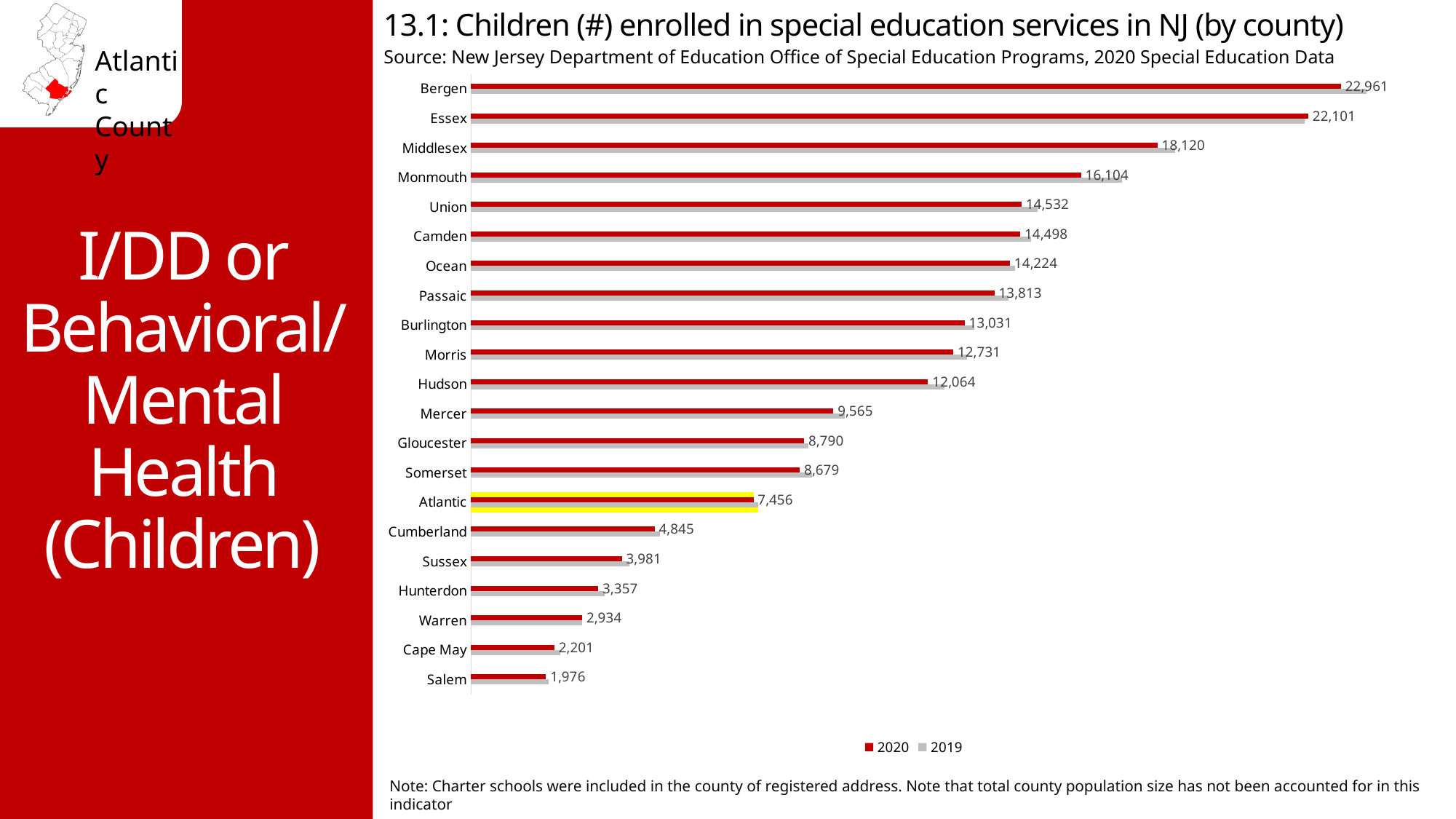
Which county has a larger 2020 value, Middlesex or Monmouth? Middlesex How many series does the legend list? 2 Which county has the highest 2020 number of children enrolled in special education services? Bergen What is the difference between the 2020 values for Bergen and Essex? 860 What is the 2020 value shown for Salem County? 1,976 What is the difference between the 2020 values for Atlantic and Cumberland? 2,611 Which county has the lowest 2020 number of children enrolled in special education services? Salem How many counties are shown in the chart? 21 What is the 2020 value shown for Bergen County? 22,961 What kind of chart is used to show children enrolled in special education services by county? Bar chart Which year does the red series in the legend represent? 2020 What is the 2020 number of children enrolled in special education services in Atlantic County? 7,456